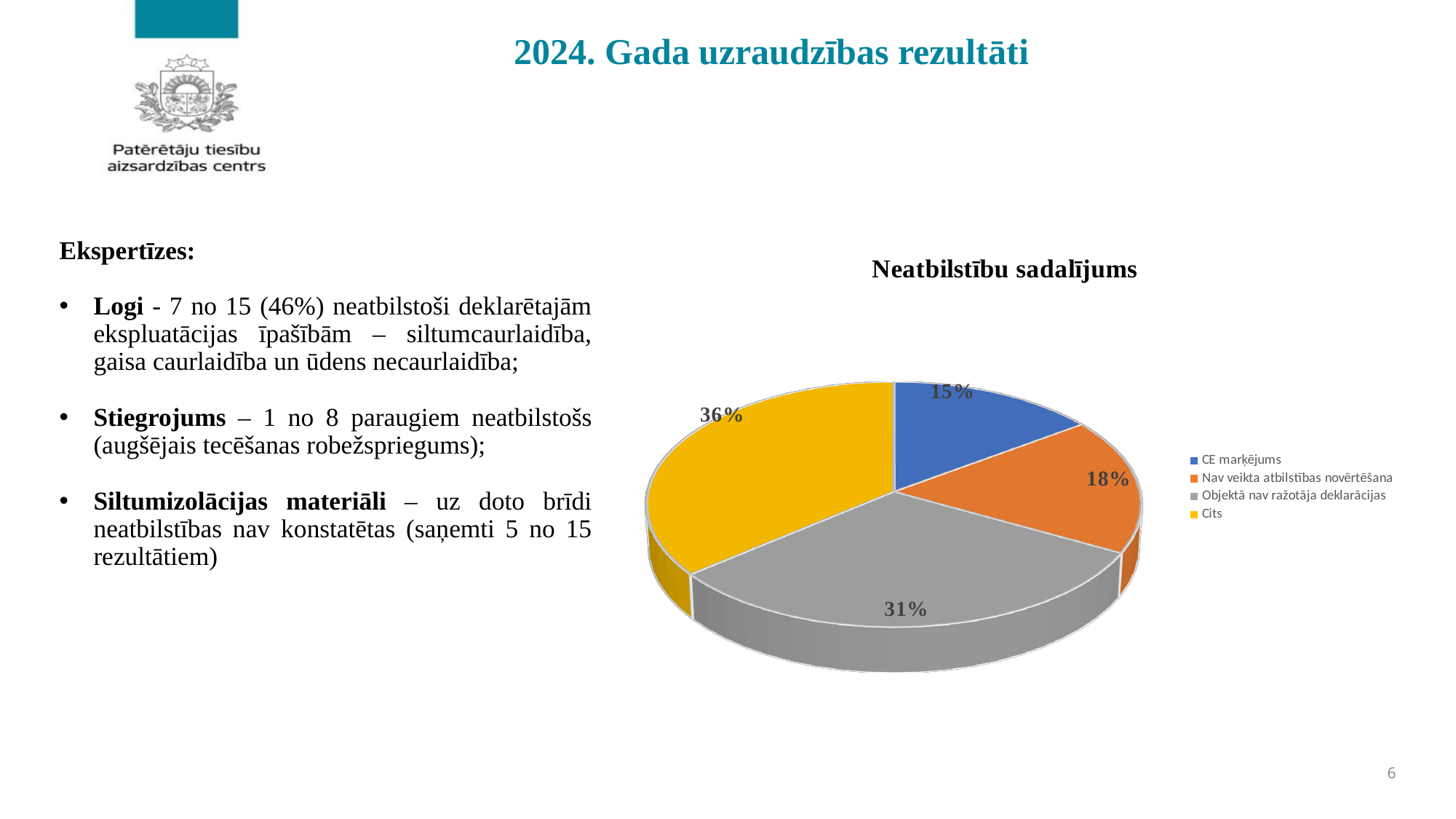
How many categories does the pie chart show? 4 What share of the pie does "CE marķējums" have? 15% Which is larger, the share for "Objektā nav ražotāja deklarācijas" or the share for "Nav veikta atbilstības novērtēšana"? Objektā nav ražotāja deklarācijas What is the difference in percentage points between "Cits" and "CE marķējums"? 21 What share of the pie does "Objektā nav ražotāja deklarācijas" have? 31% Which category has the largest share of the pie? Cits What share of the pie does "Nav veikta atbilstības novērtēšana" have? 18% What colour is the slice for "Cits"? yellow What kind of chart is shown on the slide? pie chart What is the title of the chart? Neatbilstību sadalījums Which category has the smallest share of the pie? CE marķējums